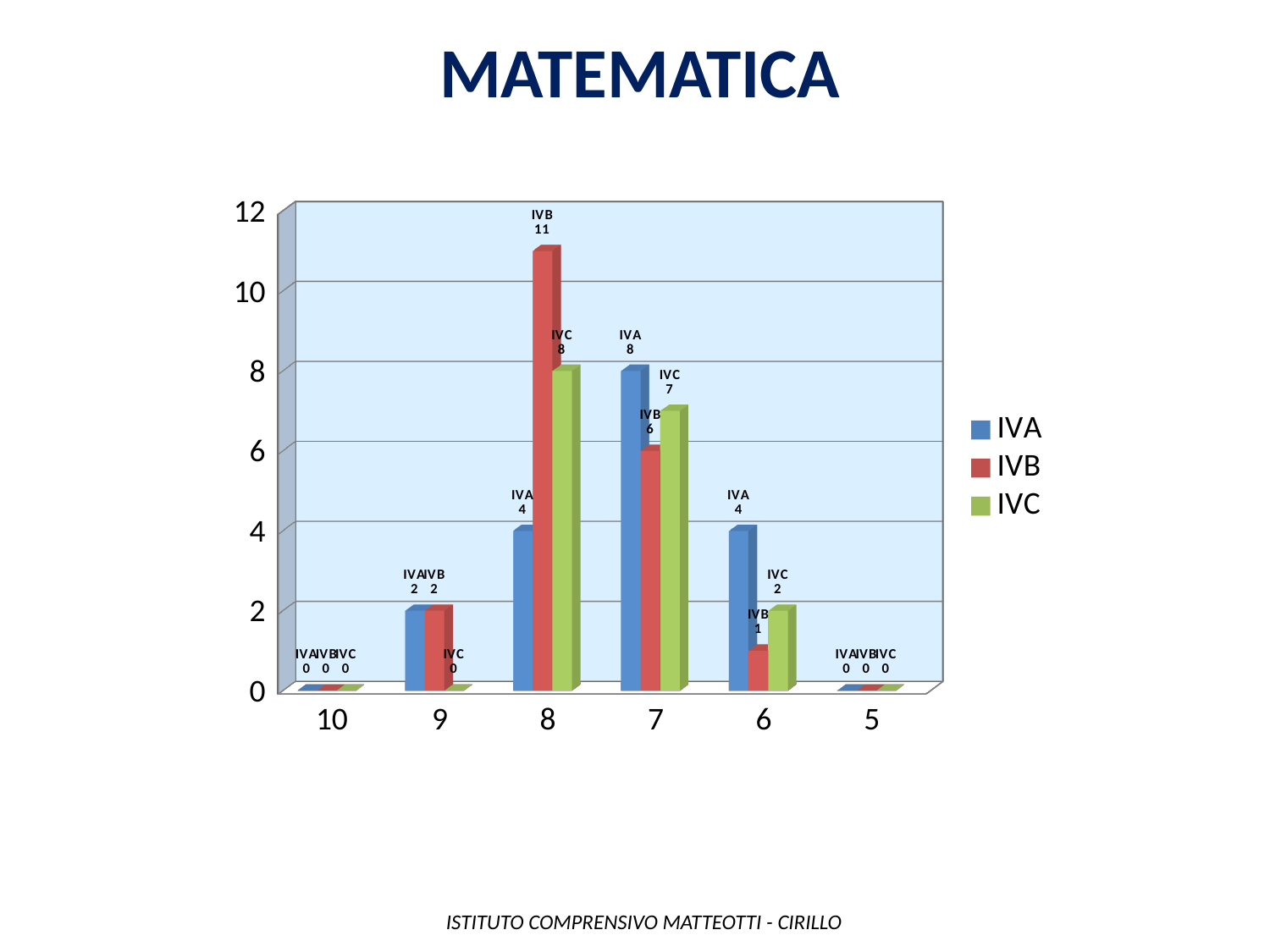
Which series has the highest value at grade 8? IVB What is the difference between IVB and IVA at grade 8? 7 How many grade categories are shown on the x axis? 6 What kind of chart is shown? bar chart How many series does the legend list? 3 What is the value for IVC at grade 9? 0 Which series has the lowest value at grade 6? IVB What is the title of the slide? MATEMATICA What is the value for IVA at grade 6? 4 What is the value for IVB at grade 8? 11 What is the value for IVC at grade 7? 7 Which is larger at grade 7: IVA or IVB? IVA